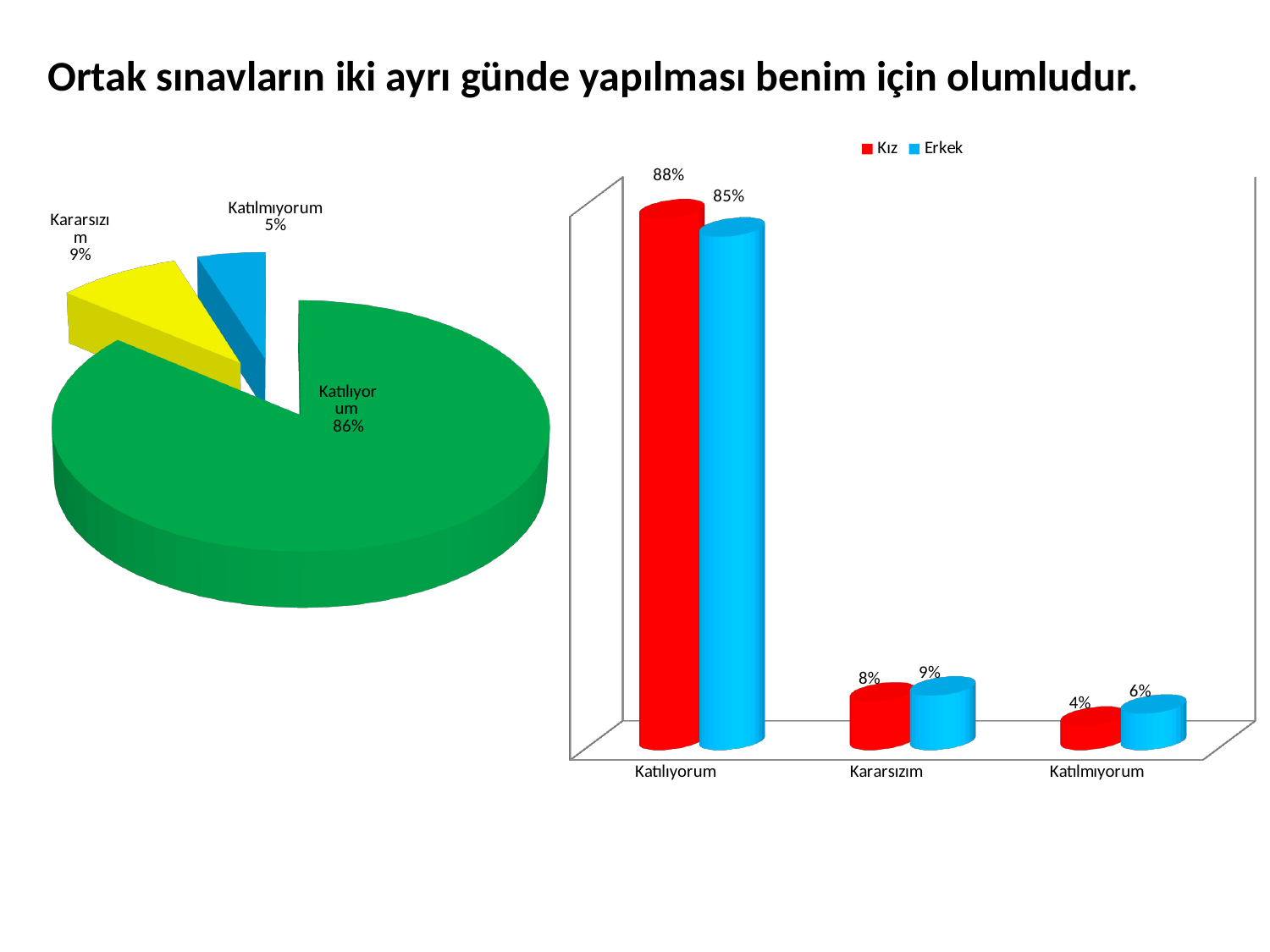
In the pie chart on the left, how many slices are there? 3 In the bar chart on the right, which category has the lowest Kız value? Katılmıyorum In the pie chart on the left, what share does Katılıyorum have? 86% In the bar chart on the right, what is the Kız value for Katılıyorum? 88% In the bar chart on the right, what is the difference between the Kız and Erkek values for Katılıyorum? 3% In the bar chart on the right, what is the Erkek value for Katılmıyorum? 6% In the pie chart on the left, which category has the smallest slice? Katılmıyorum In the pie chart on the left, what share does Kararsızım have? 9% What kind of chart is on the left of the slide? Pie chart What kind of chart is on the right of the slide? Bar chart In the bar chart on the right, how many series does the legend list? 2 In the bar chart on the right, which is larger for Kararsızım, Kız or Erkek? Erkek